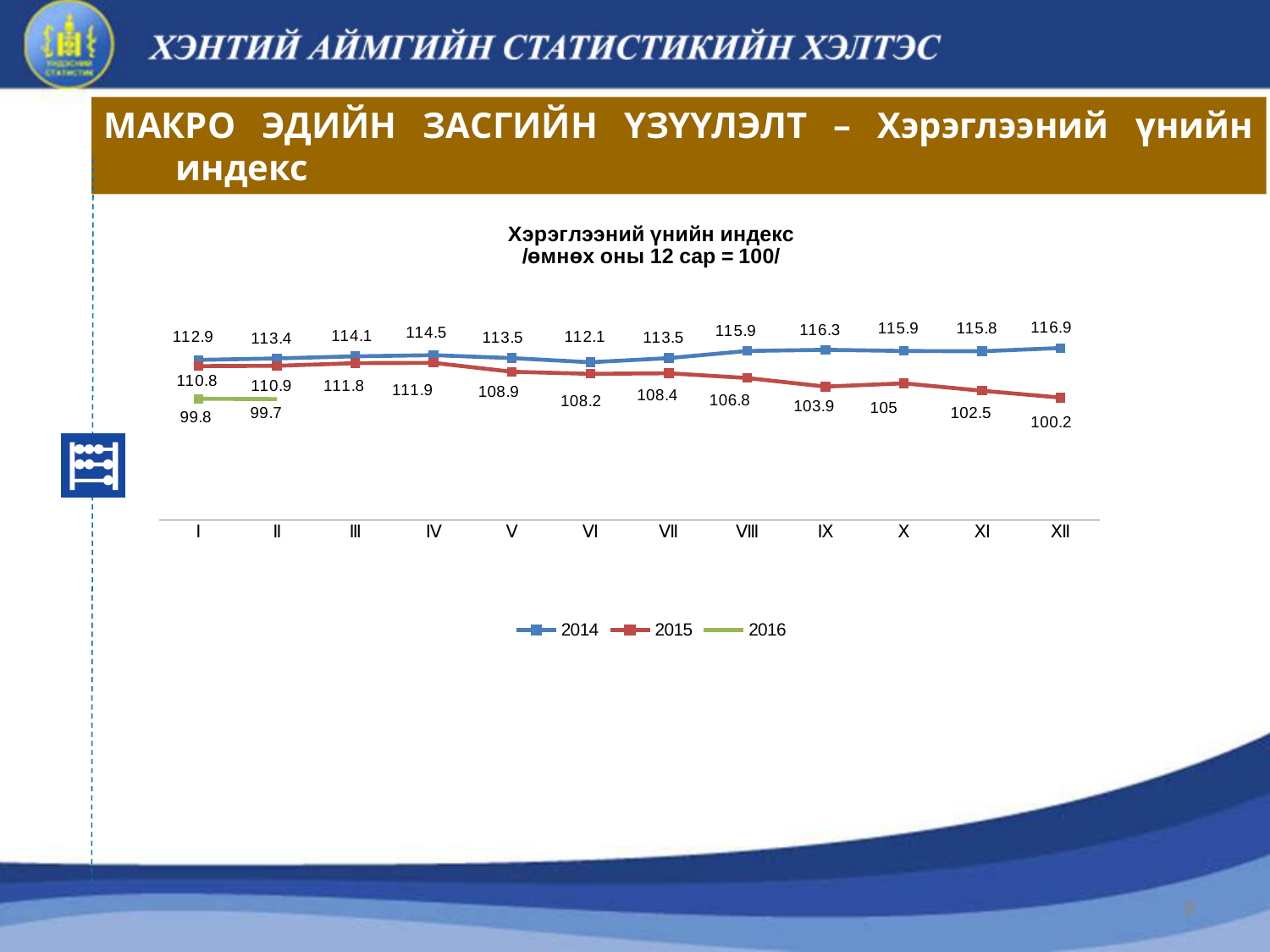
What is the value for 2014 in month XII? 116.9 In which month is the 2014 series at its highest? XII How many series does the legend list? 3 Does the 2015 series generally rise or fall from month I to month XII? fall What is the value for 2015 in month IX? 103.9 What is the value for 2016 in month II? 99.7 In which month is the 2015 series at its lowest? XII What is the difference between the 2014 and 2015 values in month XII? 16.7 Which is larger in month V, the 2014 value or the 2015 value? 2014 What type of chart is shown on the slide? line chart How many categories are shown on the x axis? 12 Which series is drawn in green in the legend? 2016